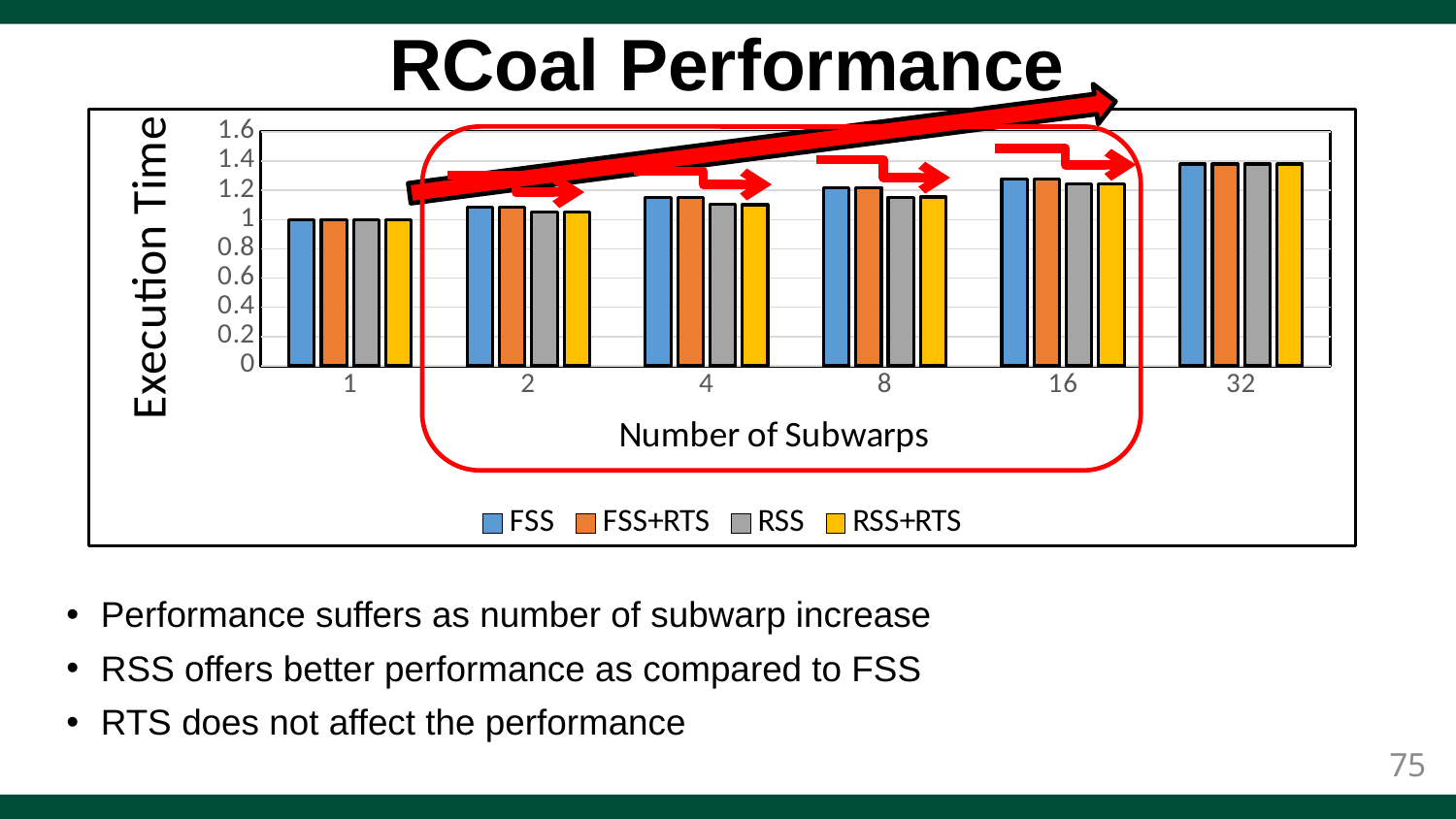
Do the FSS values rise or fall as the number of subwarps increases along the x axis? rise Which is larger, the RSS+RTS value for 32 subwarps or the RSS+RTS value for 1 subwarp? 32 subwarps Is the RSS value for 16 subwarps greater or less than 1.4? less What kind of chart is shown on the slide? bar chart Is the FSS+RTS value for 2 subwarps greater or less than 1? greater For which number of subwarps is the RSS execution time lowest? 1 What is the title of the y axis? Execution Time How many categories are shown on the x axis? 6 Is the FSS value for 32 subwarps greater or less than 1.2? greater For which number of subwarps is the FSS execution time highest? 32 How many series does the legend list? 4 What is the title of the x axis? Number of Subwarps